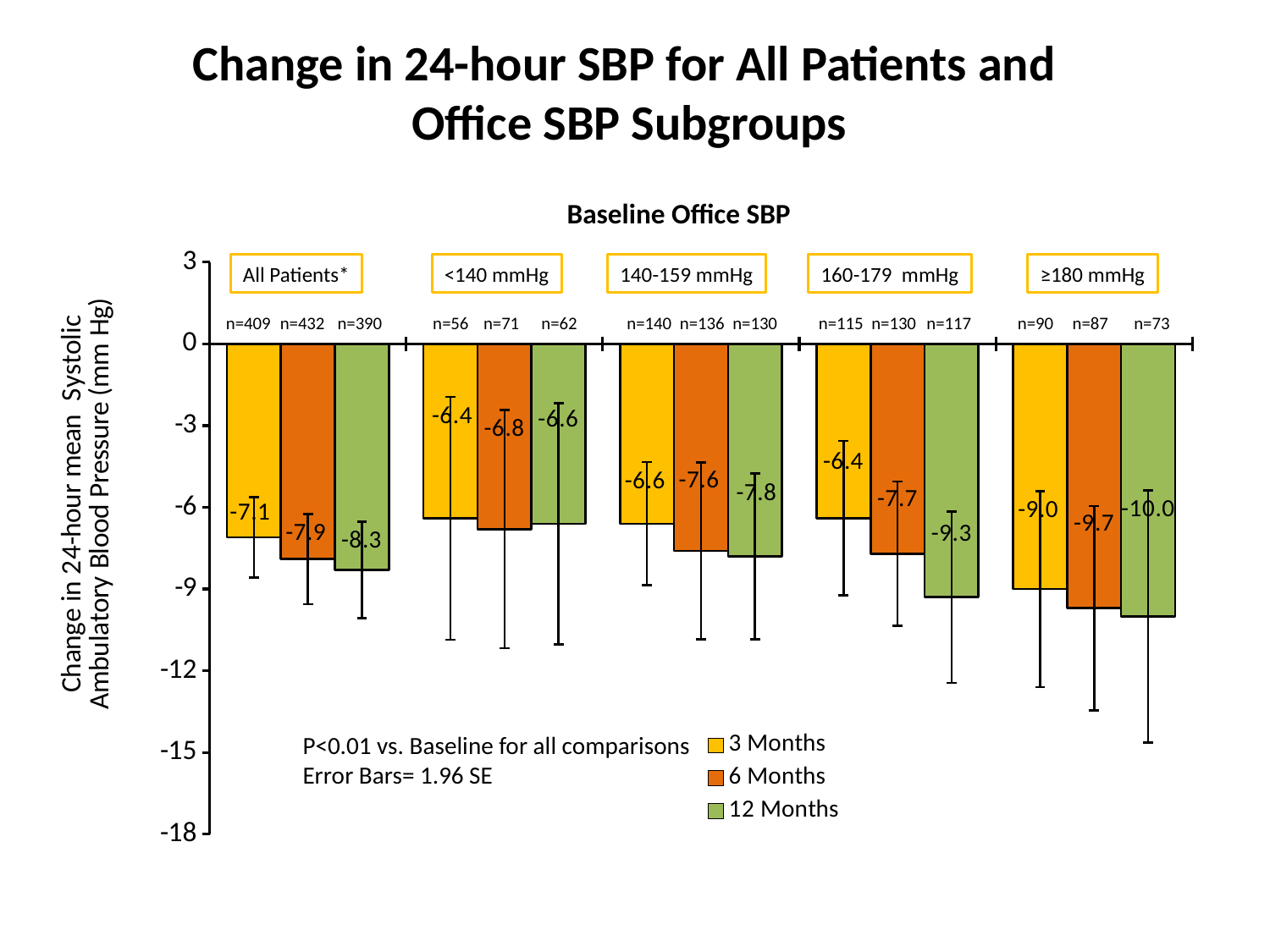
What is the value for the 3 Months series in the ≥180 mmHg subgroup? -9.0 What kind of chart is shown on the slide? Bar chart What is the value for the 6 Months series in the 140-159 mmHg subgroup? -7.6 What is the change in 24-hour mean systolic ambulatory blood pressure at 12 Months for All Patients? -8.3 Which subgroup has the smallest reduction (least negative value) at 3 Months? 160-179 mmHg and <140 mmHg (both -6.4) How many baseline office SBP groups are shown on the x axis? 5 What is the value for the 12 Months series in the 160-179 mmHg subgroup? -9.3 What is the sample size (n) for the 6 Months bar in the All Patients group? n=432 How many series does the legend list? 3 What is the difference between the 3 Months and 12 Months values in the 160-179 mmHg subgroup? 2.9 Which subgroup has the largest reduction (most negative value) at 12 Months? ≥180 mmHg In the <140 mmHg subgroup, which shows a larger reduction: 6 Months or 12 Months? 6 Months